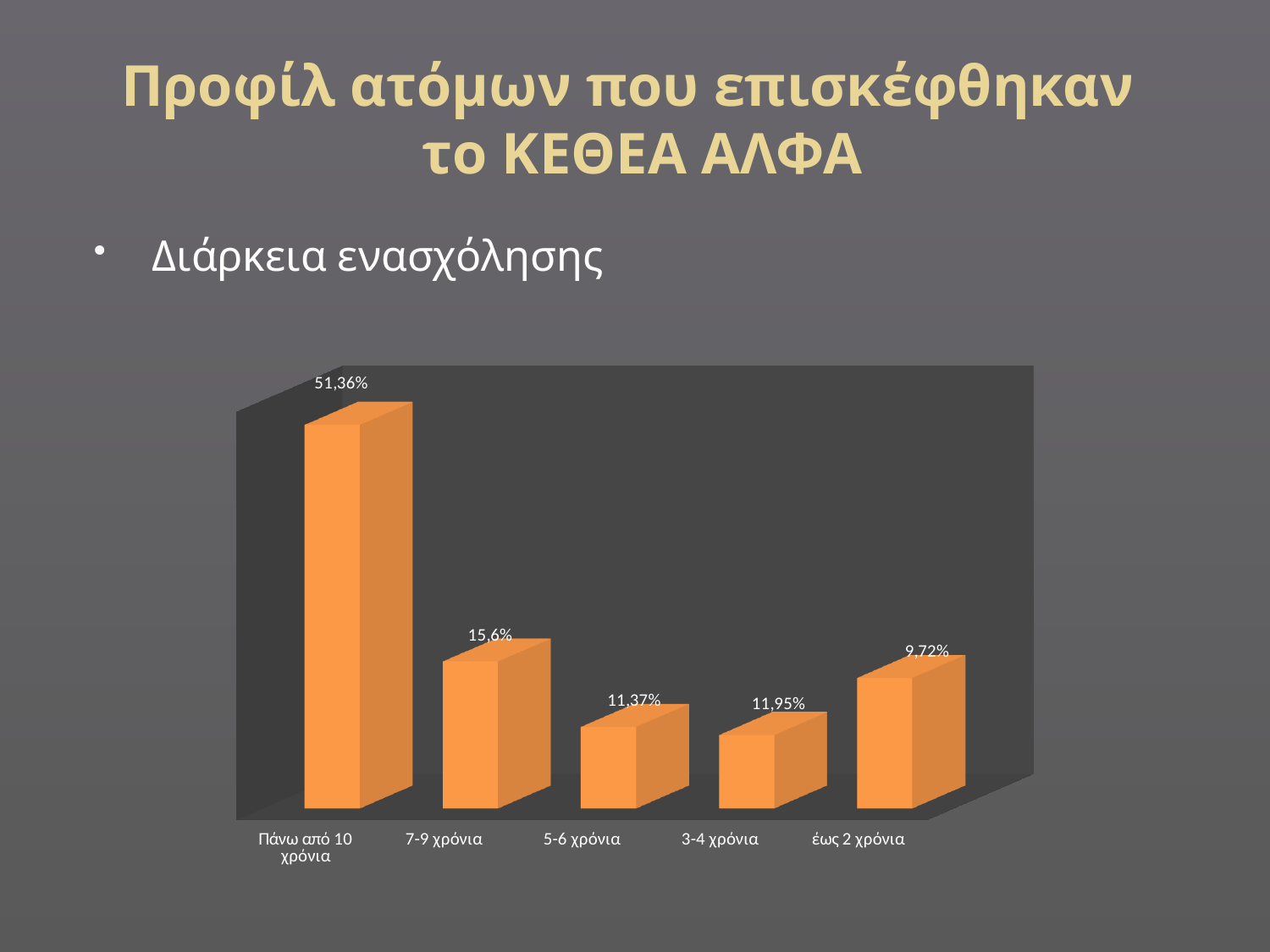
What is the value for έως 2 χρόνια? 9,72% What is the value for 3-4 χρόνια? 11,95% What kind of chart is shown on the slide? Bar chart What is the difference between the values for Πάνω από 10 χρόνια and 7-9 χρόνια? 35,76% What is the value for 7-9 χρόνια? 15,6% How many categories are shown in the chart? 5 Which category has the highest value? Πάνω από 10 χρόνια What is the value for Πάνω από 10 χρόνια? 51,36% What is the value for 5-6 χρόνια? 11,37% What is the difference between the values for 3-4 χρόνια and 5-6 χρόνια? 0,58%